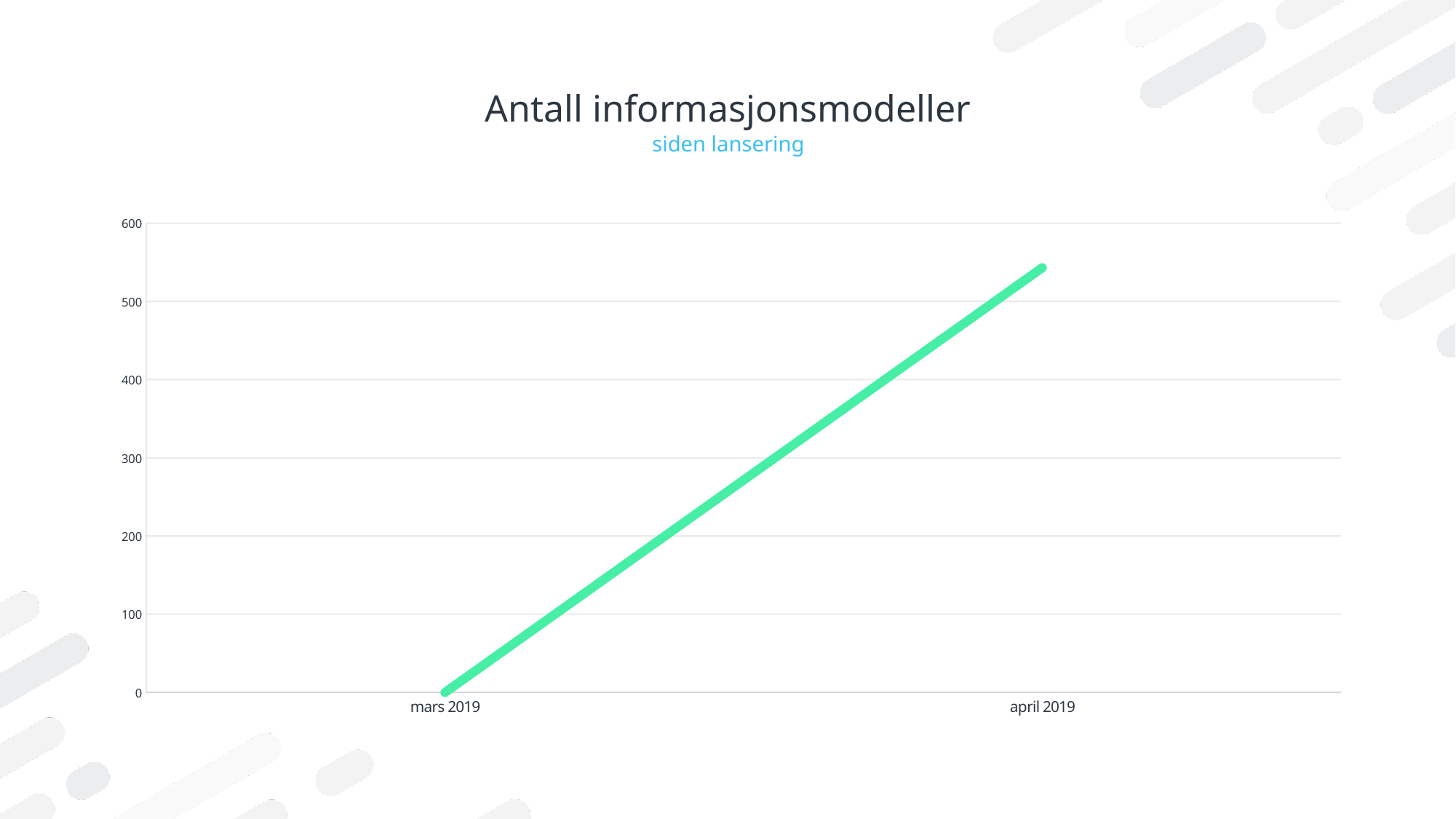
Is the value for april 2019 greater or less than 500? greater Do the values rise or fall from mars 2019 to april 2019? rise Which is larger, the value for mars 2019 or the value for april 2019? april 2019 What is the subtitle shown under the chart title? siden lansering What is the value for mars 2019? 0 What is the highest value shown on the vertical axis? 600 Is the value for april 2019 greater or less than 600? less What is the title of the chart? Antall informasjonsmodeller How many data points are plotted on the line? 2 Which point has the highest value? april 2019 What kind of chart is shown on the slide? line chart Which point has the lowest value? mars 2019